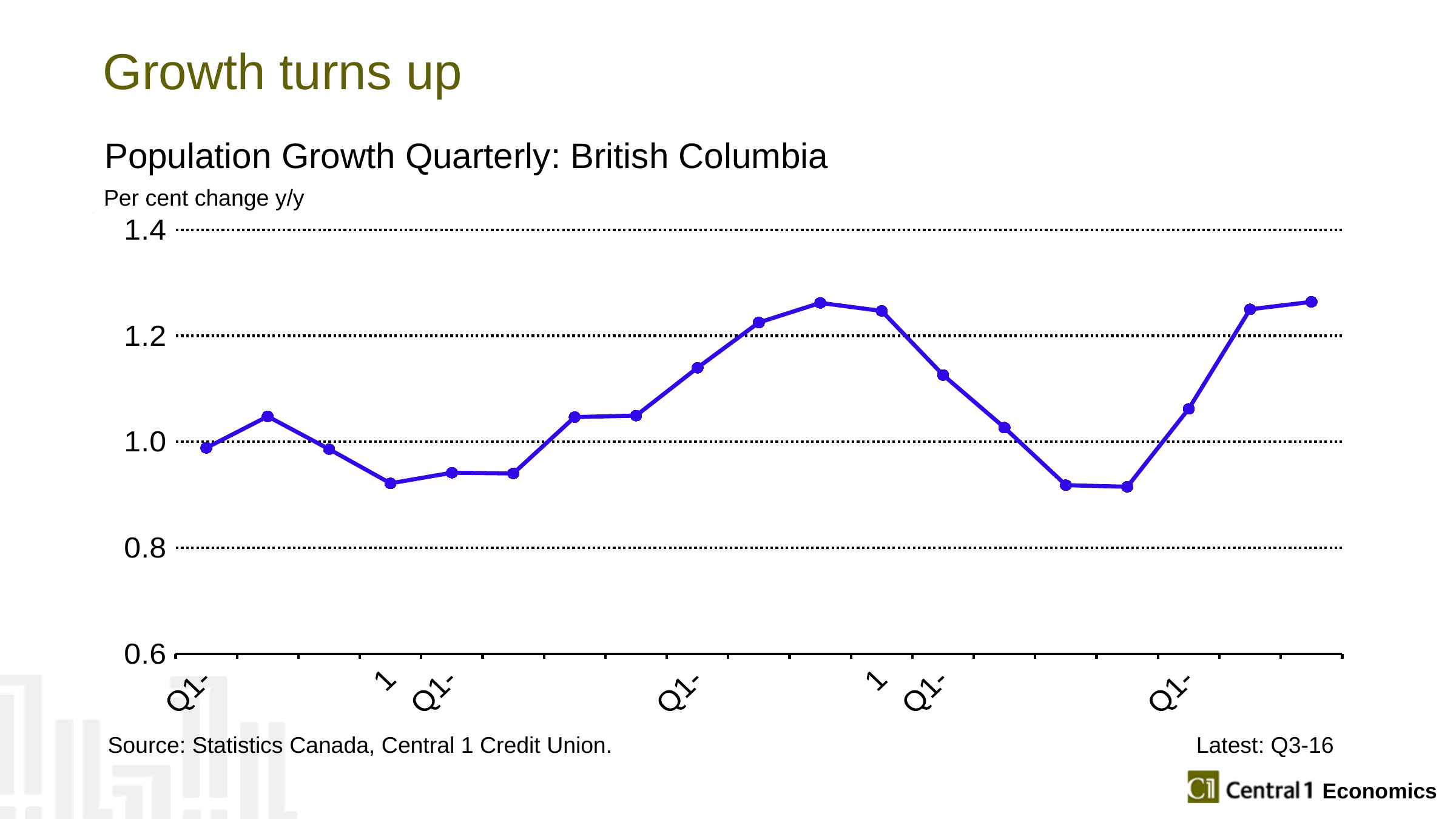
What is the highest value shown on the y axis? 1.4 Does the line rise or fall over its final three points? rise What kind of chart is shown on the slide? line chart Is the highest point on the line greater or less than 1.2? greater Is the lowest point on the line greater or less than 1.0? less What unit is the y axis of the chart measured in? Per cent change y/y Is the value of the last point on the line higher or lower than the value of the first point? higher Is the value of the second point on the line greater or less than 1.0? greater What is the title of the chart? Population Growth Quarterly: British Columbia How many data points are plotted on the line? 19